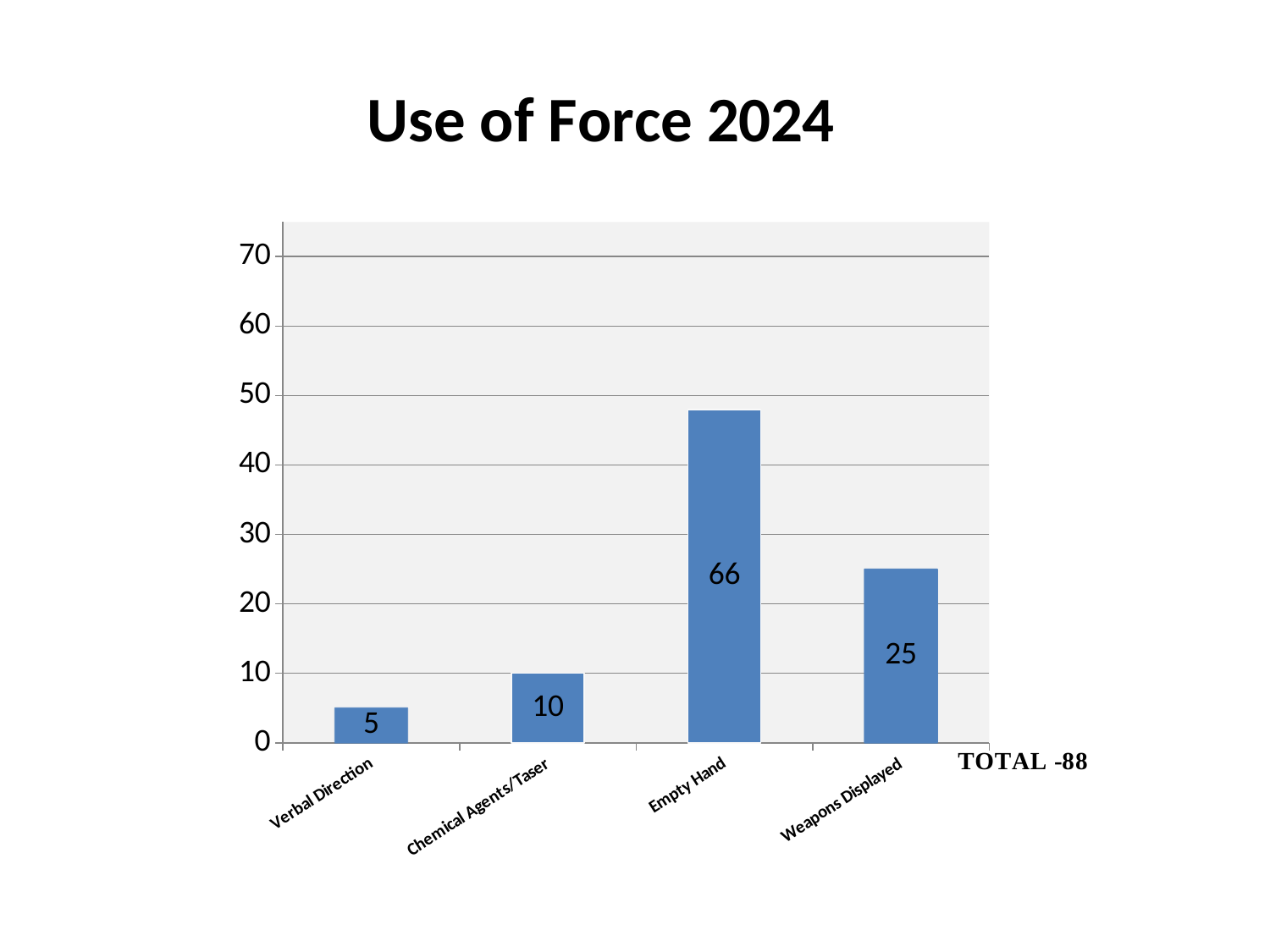
What is the value for Verbal Direction? 5 What is the difference between the values for Weapons Displayed and Chemical Agents/Taser? 15 What is the difference between the values for Chemical Agents/Taser and Verbal Direction? 5 How many categories are shown on the x axis? 4 What kind of chart is shown on the slide? bar chart What is the value for Weapons Displayed? 25 Which is larger, the value for Weapons Displayed or the value for Chemical Agents/Taser? Weapons Displayed Is the value for Weapons Displayed greater or less than 20? greater Which category has the highest value? Empty Hand Which category has the lowest value? Verbal Direction What is the value for Chemical Agents/Taser? 10